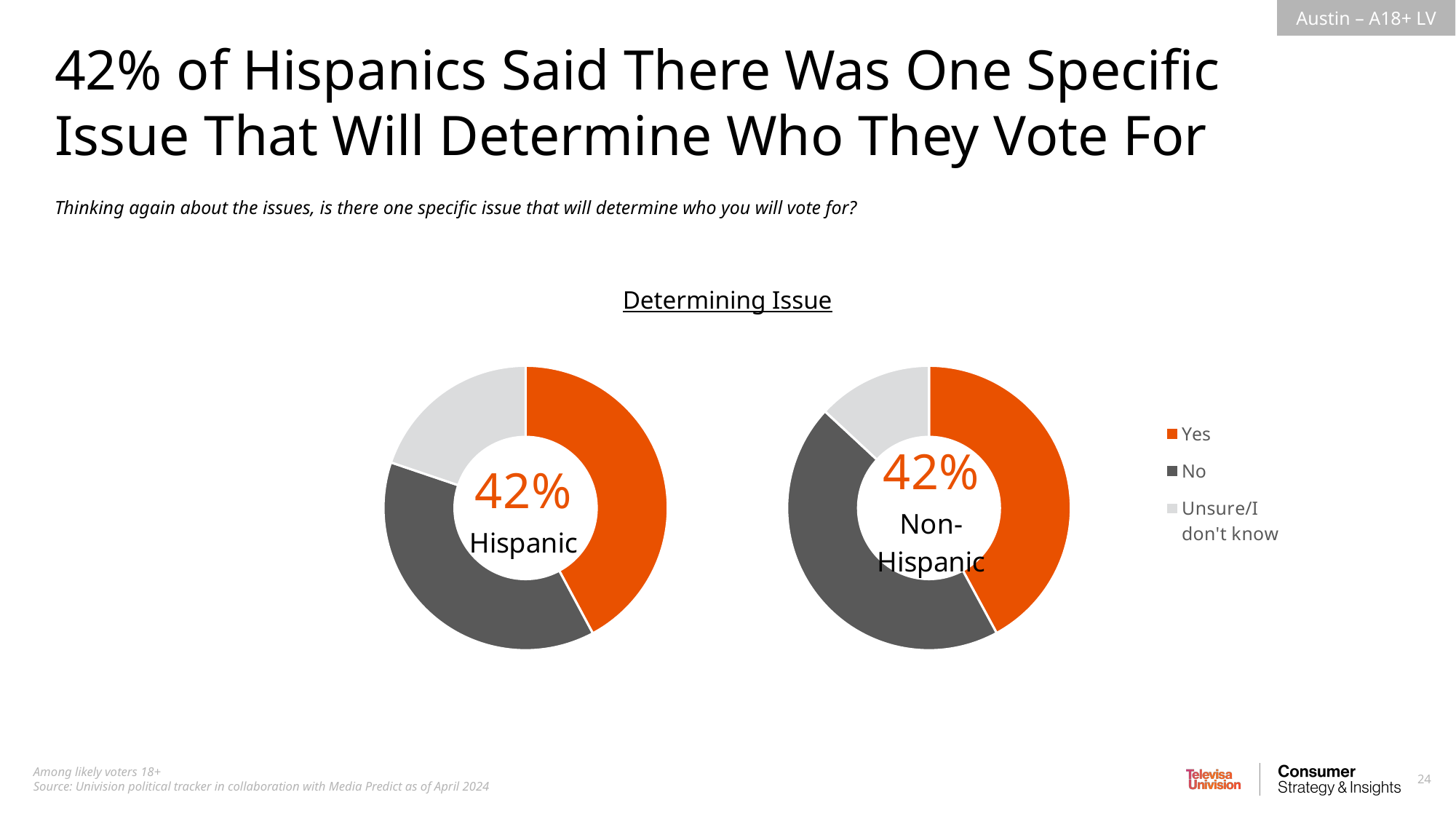
What is the title shown above the two donut charts? Determining Issue In the Non-Hispanic chart, which slice is larger: No or Unsure/I don't know? No What kind of chart is used to show the Hispanic results? Pie (donut) chart In the Hispanic chart, which slice is larger: Yes or Unsure/I don't know? Yes In the Non-Hispanic chart, which response has the smallest slice? Unsure/I don't know In the Non-Hispanic donut chart, what percentage answered Yes? 42% In the Hispanic donut chart, what percentage answered Yes? 42% Which colour represents the Yes response in the charts? Orange How many donut charts are shown on the slide? 2 In the Hispanic chart, which response has the smallest slice? Unsure/I don't know How many slices does the Non-Hispanic donut chart have? 3 How many response categories does the legend list? 3